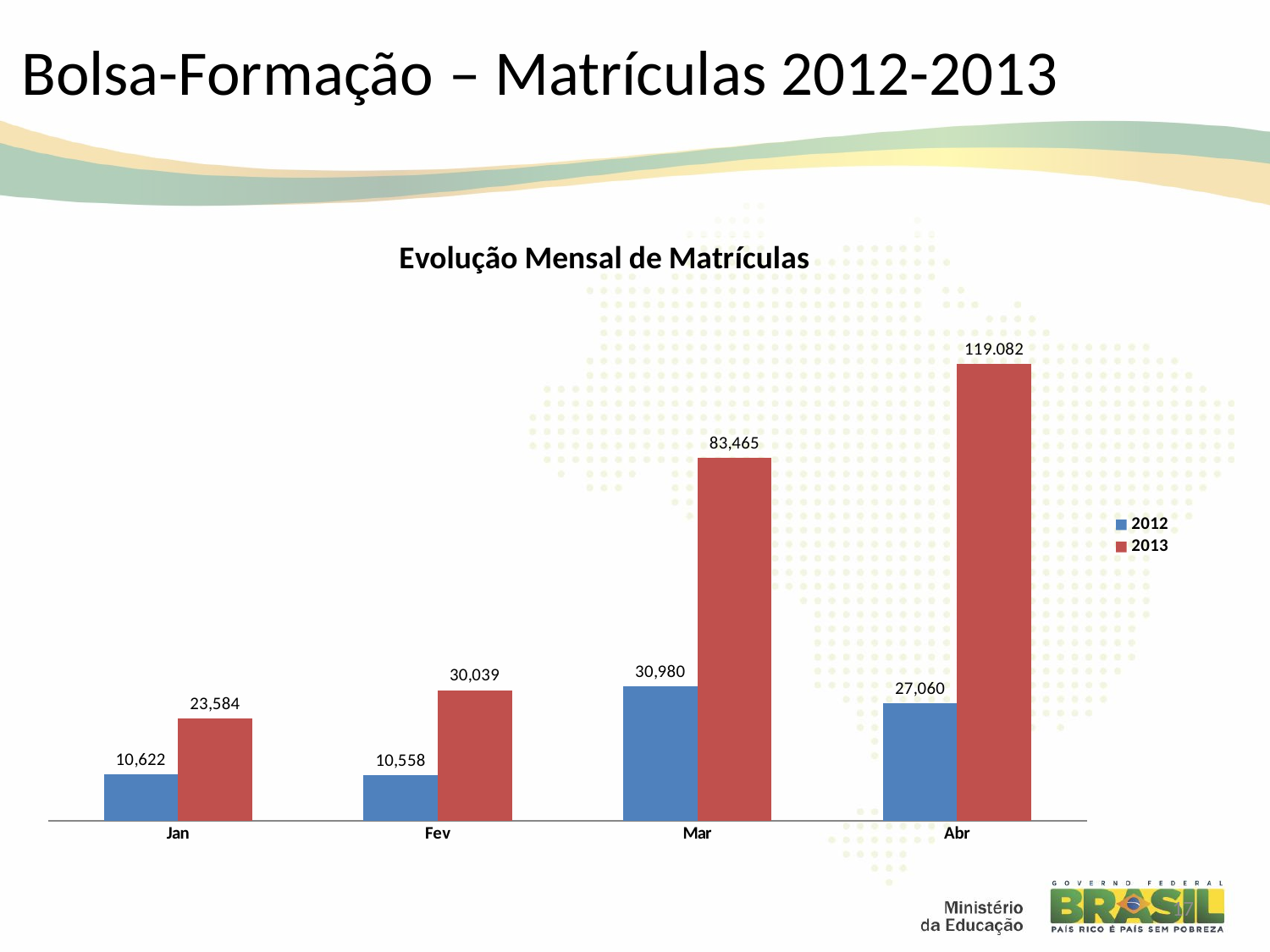
What is the title of the chart? Evolução Mensal de Matrículas What is the value for 2013 in Mar? 83,465 How many months are shown on the x axis? 4 What is the value for 2013 in Abr? 119.082 How many series does the legend list? 2 Which month has the highest value for the 2013 series? Abr What is the difference between the 2013 and 2012 values in Mar? 52,485 What is the value for 2012 in Jan? 10,622 Which month has the highest value for the 2012 series? Mar What type of chart is shown on the slide? bar chart Do the 2013 values rise or fall from Jan to Abr? rise What is the value for 2012 in Abr? 27,060